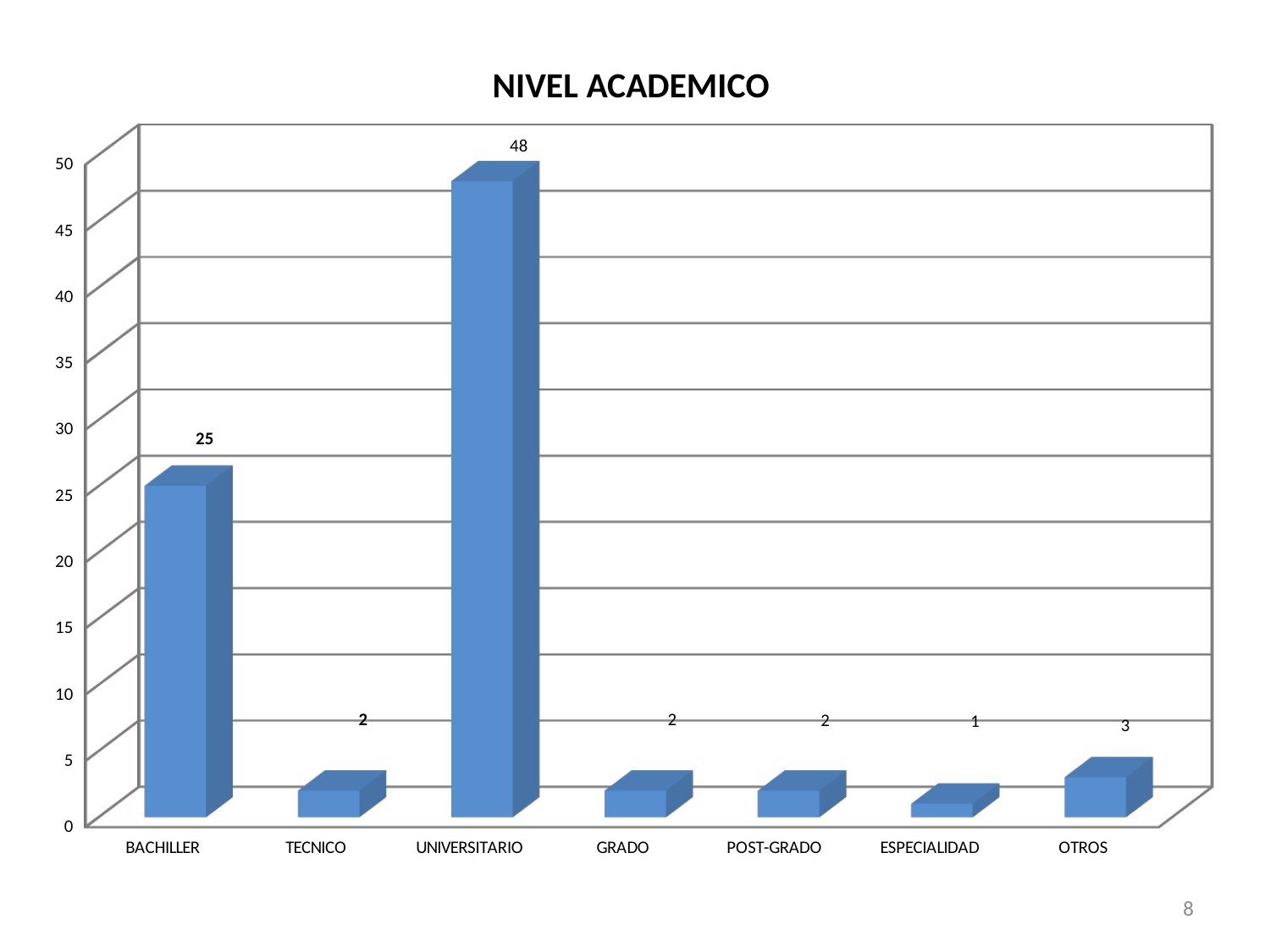
What is the value for UNIVERSITARIO? 48 What kind of chart is shown on the slide? bar chart What is the value for BACHILLER? 25 What is the value for ESPECIALIDAD? 1 What is the title of the chart? NIVEL ACADEMICO How many categories are shown on the x axis? 7 Which category has the highest value? UNIVERSITARIO What is the difference between the values for UNIVERSITARIO and BACHILLER? 23 What is the value for OTROS? 3 Is the value for BACHILLER greater or less than 20? greater Which is larger, the value for OTROS or the value for TECNICO? OTROS Which category has the lowest value? ESPECIALIDAD